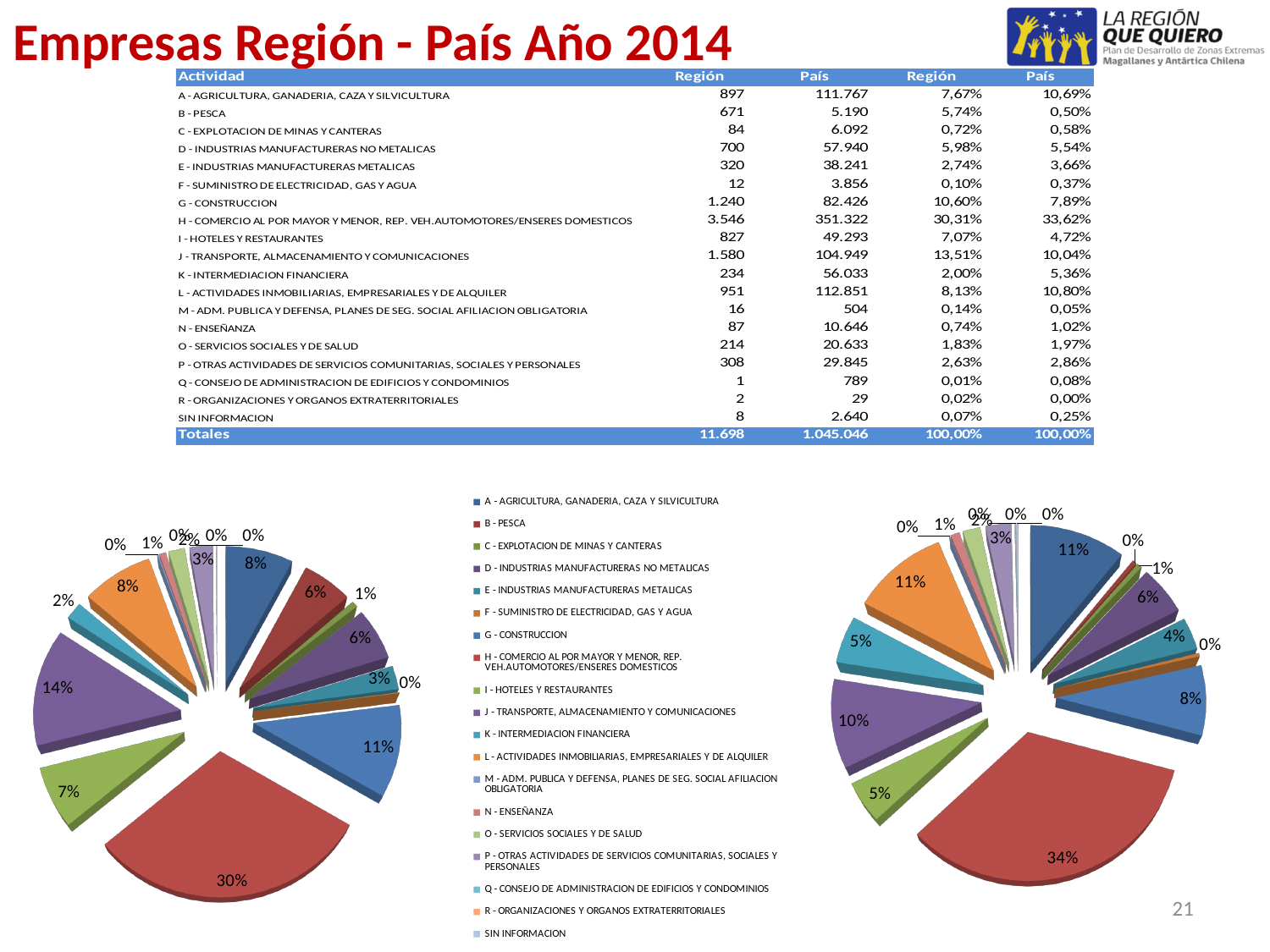
How many slices in the right pie chart are labeled 11%? 2 How many entries does the legend between the two pie charts list? 19 How many pie charts are shown on the slide? 2 In the right pie chart, what is the percentage shown on the largest slice? 34% Which pie chart has the larger largest slice, the left one or the right one? the right one Is the largest slice of the right pie chart greater or less than 30%? greater What is the difference between the largest slice of the right pie chart and the largest slice of the left pie chart? 4 percentage points Which activity does the largest (red) slice of the left pie chart represent? H - COMERCIO AL POR MAYOR Y MENOR, REP. VEH.AUTOMOTORES/ENSERES DOMESTICOS In the left pie chart, what is the percentage shown on the largest slice? 30% What is the title of the slide? Empresas Región - País Año 2014 What kind of chart is the chart on the left of the slide? pie chart In the left pie chart, what is the percentage shown on the second-largest slice? 14%